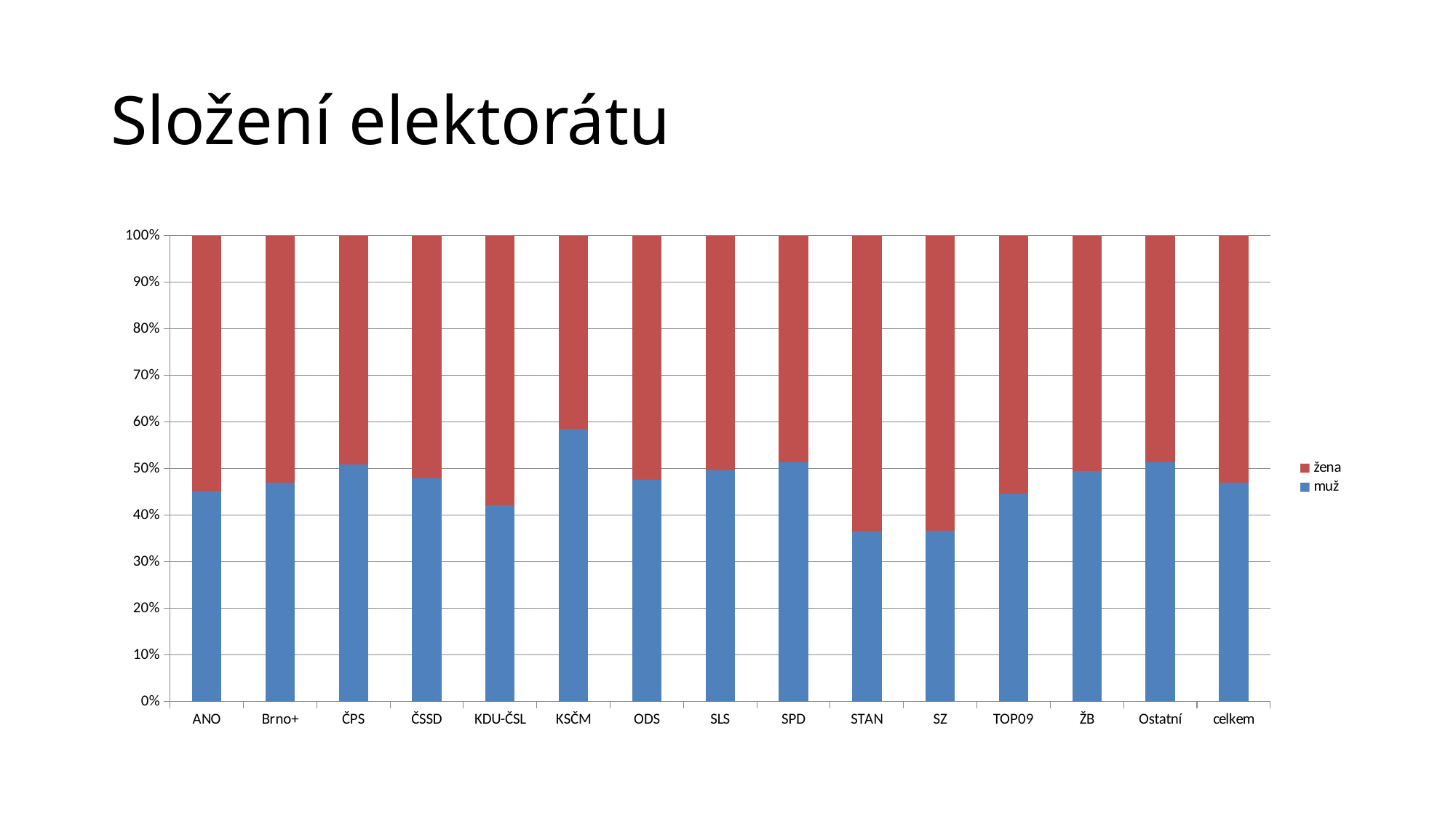
Which has a larger žena share, STAN or KSČM? STAN Which has a larger muž share, KSČM or ANO? KSČM What is the title of the slide containing the chart? Složení elektorátu Which category has the highest share for the muž series? KSČM Is the muž share for KSČM greater or less than 50%? greater Is the muž share for KDU-ČSL greater or less than 40%? greater Which colour represents the žena series in the chart? red Is the muž share for ANO greater or less than 50%? less How many categories are shown along the x axis of the chart? 15 How many series does the chart's legend list? 2 What kind of chart is shown on the slide? bar chart